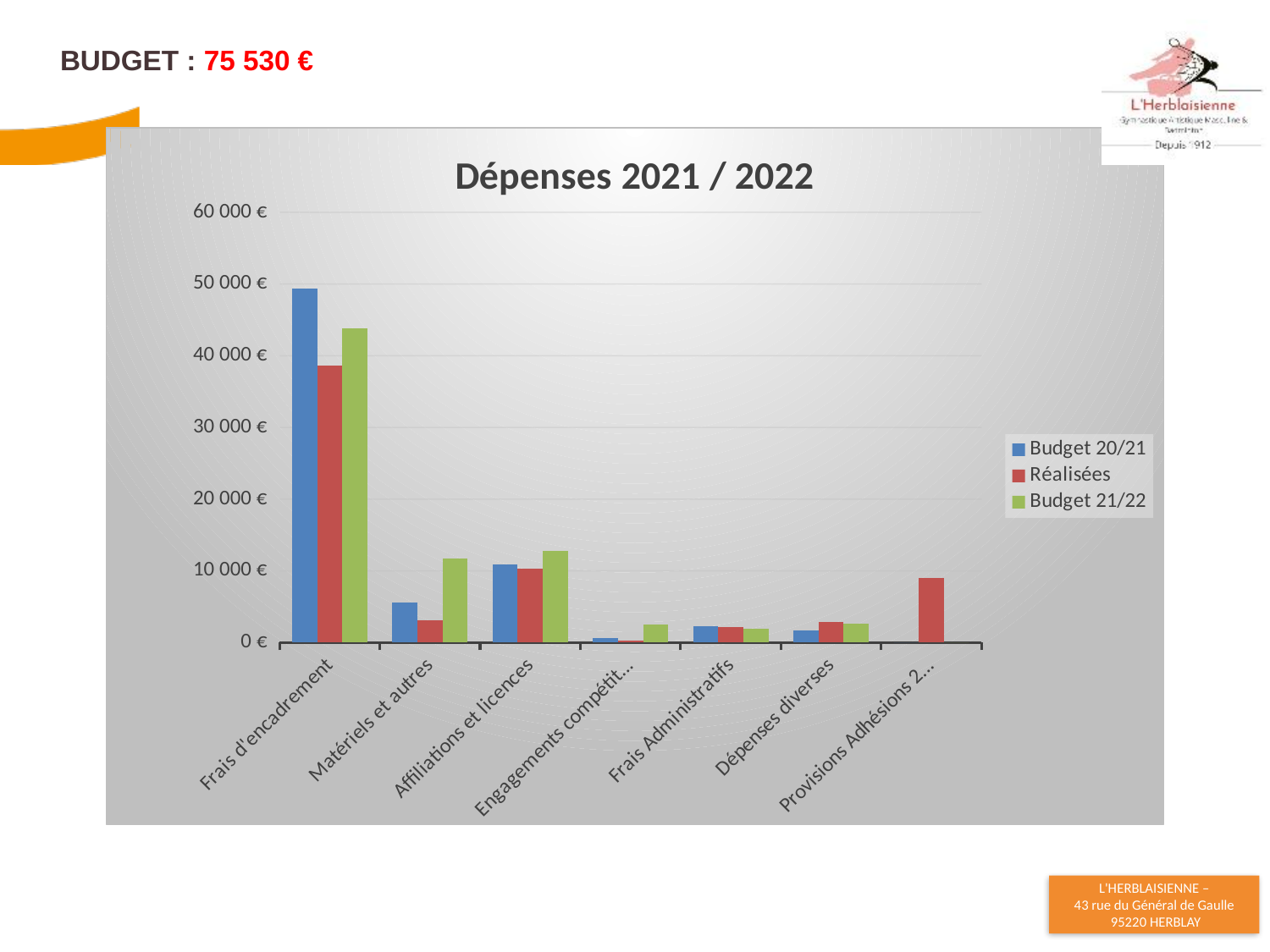
Is the Budget 20/21 value for Frais d'encadrement greater or less than 40 000 €? greater What kind of chart is shown on the slide? bar chart Is the Réalisées value for Frais d'encadrement greater or less than 40 000 €? less How many categories are shown on the x axis of the chart? 7 Which category has the highest Réalisées value? Frais d'encadrement For Frais d'encadrement, which is larger: the Budget 20/21 value or the Réalisées value? Budget 20/21 How many series does the chart legend list? 3 Which colour represents the Réalisées series in the chart? red Is the Réalisées value for Provisions Adhésions greater or less than 10 000 €? less Which category has the highest Budget 20/21 value? Frais d'encadrement What is the title of the chart? Dépenses 2021 / 2022